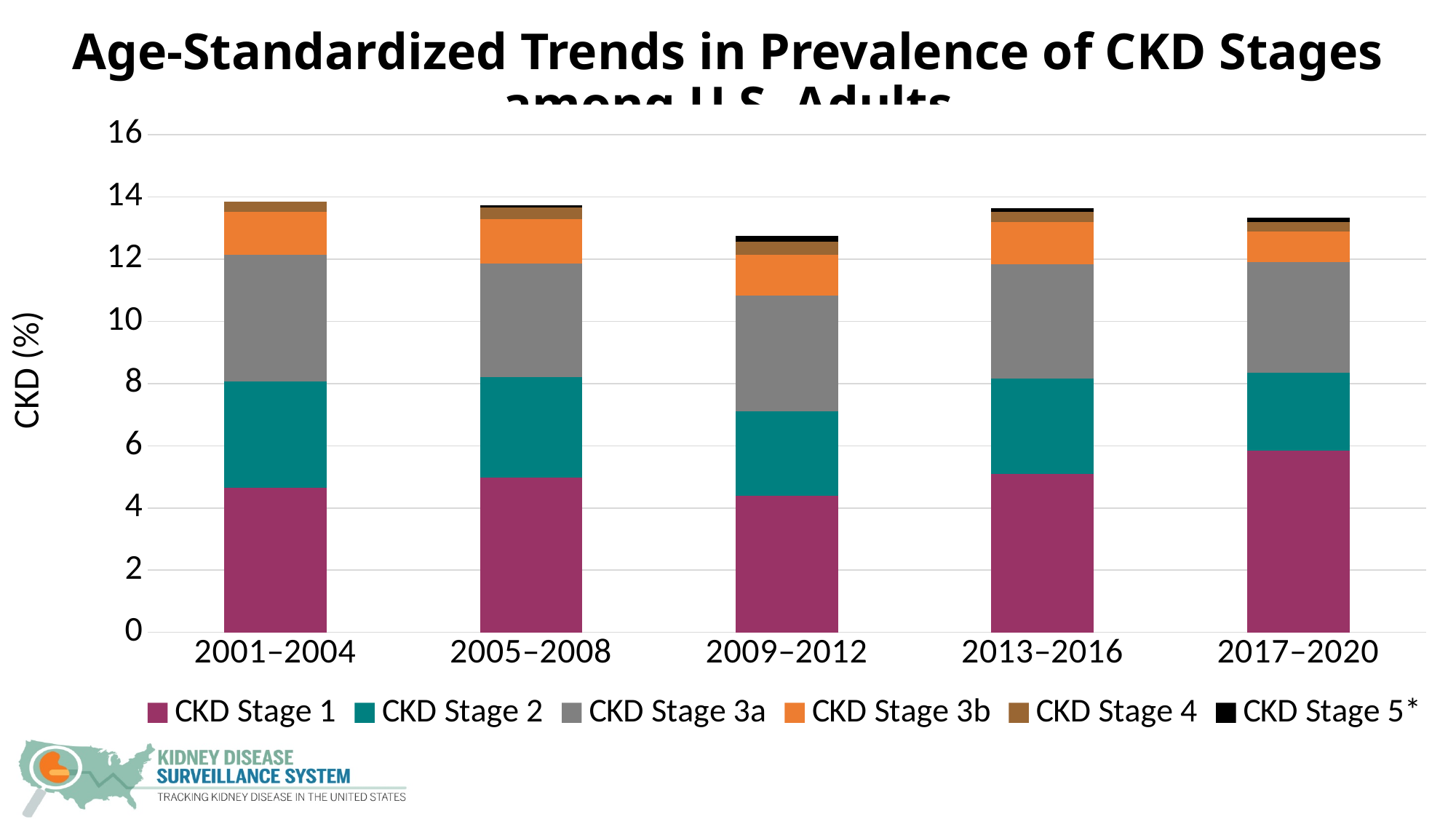
In which time period is the CKD Stage 1 segment the largest? 2017–2020 Is the total CKD prevalence for 2009–2012 greater or less than 14? less What is the label on the y axis? CKD (%) Is the total CKD prevalence for 2001–2004 greater or less than 12? greater How many time periods are shown on the x axis? 5 Is the CKD Stage 1 value for 2017–2020 greater or less than 4? greater How many series does the legend list? 6 Which legend entry is marked with an asterisk? CKD Stage 5* Which period has a larger CKD Stage 1 value, 2001–2004 or 2017–2020? 2017–2020 Which has the larger total CKD prevalence, 2009–2012 or 2013–2016? 2013–2016 Which time period has the lowest total CKD prevalence? 2009–2012 What kind of chart is shown on the slide? Stacked bar chart